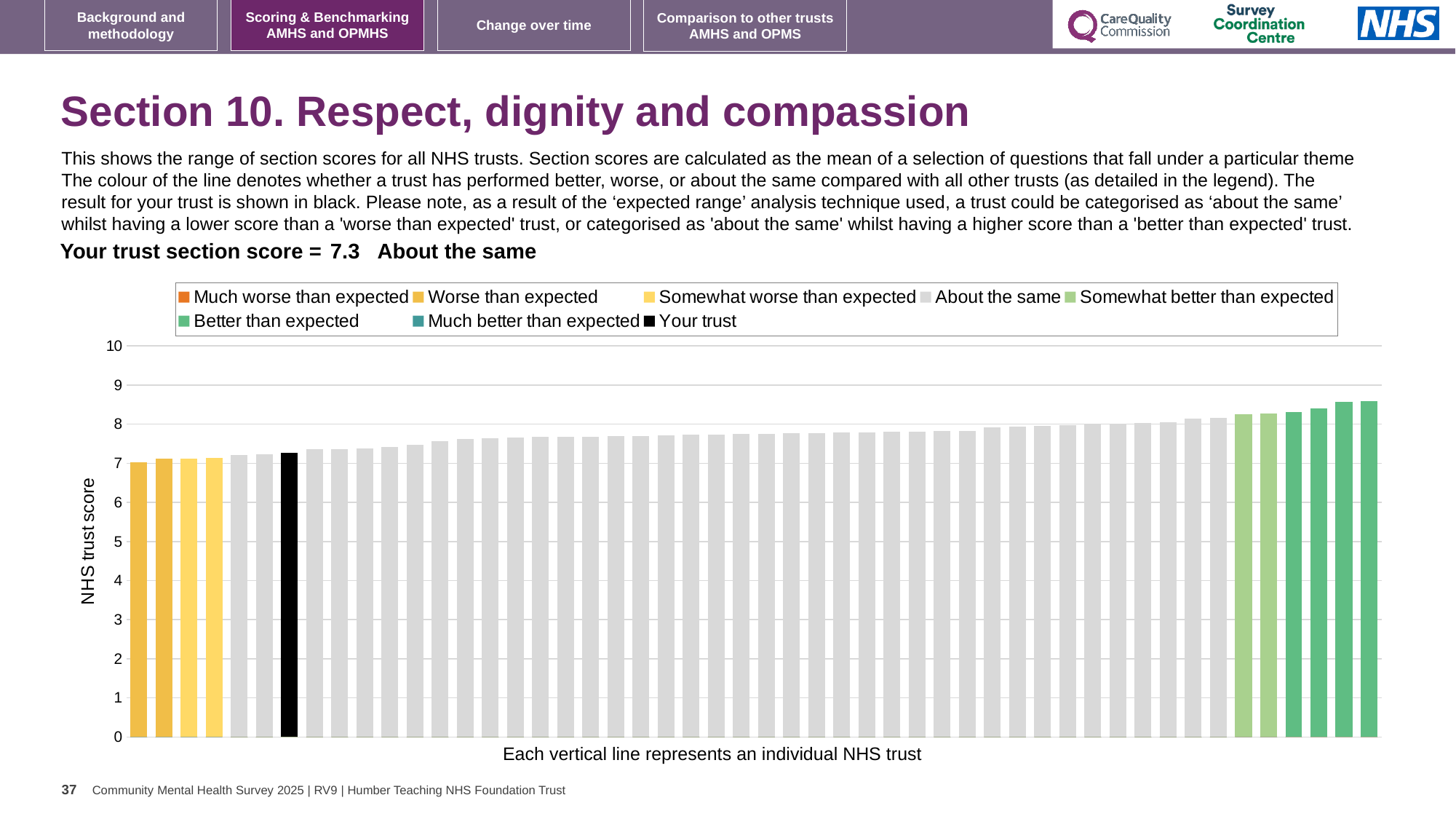
What is the label on the vertical axis of the chart? NHS trust score Which performance category is your trust placed in for this section? About the same Do the bar values rise or fall from left to right across the chart? rise Is the value of the tallest bar in the chart greater or less than 8? greater Is the value of the tallest bar in the chart greater or less than 9? less Is the value of the black bar (your trust) greater or less than 8? less How many entries does the chart legend list? 8 Which legend category does the shortest bar on the far left of the chart belong to? Worse than expected What kind of chart is shown on the slide? bar chart Which legend category do the tallest bars on the right of the chart belong to? Better than expected What is the section score for your trust shown on the slide? 7.3